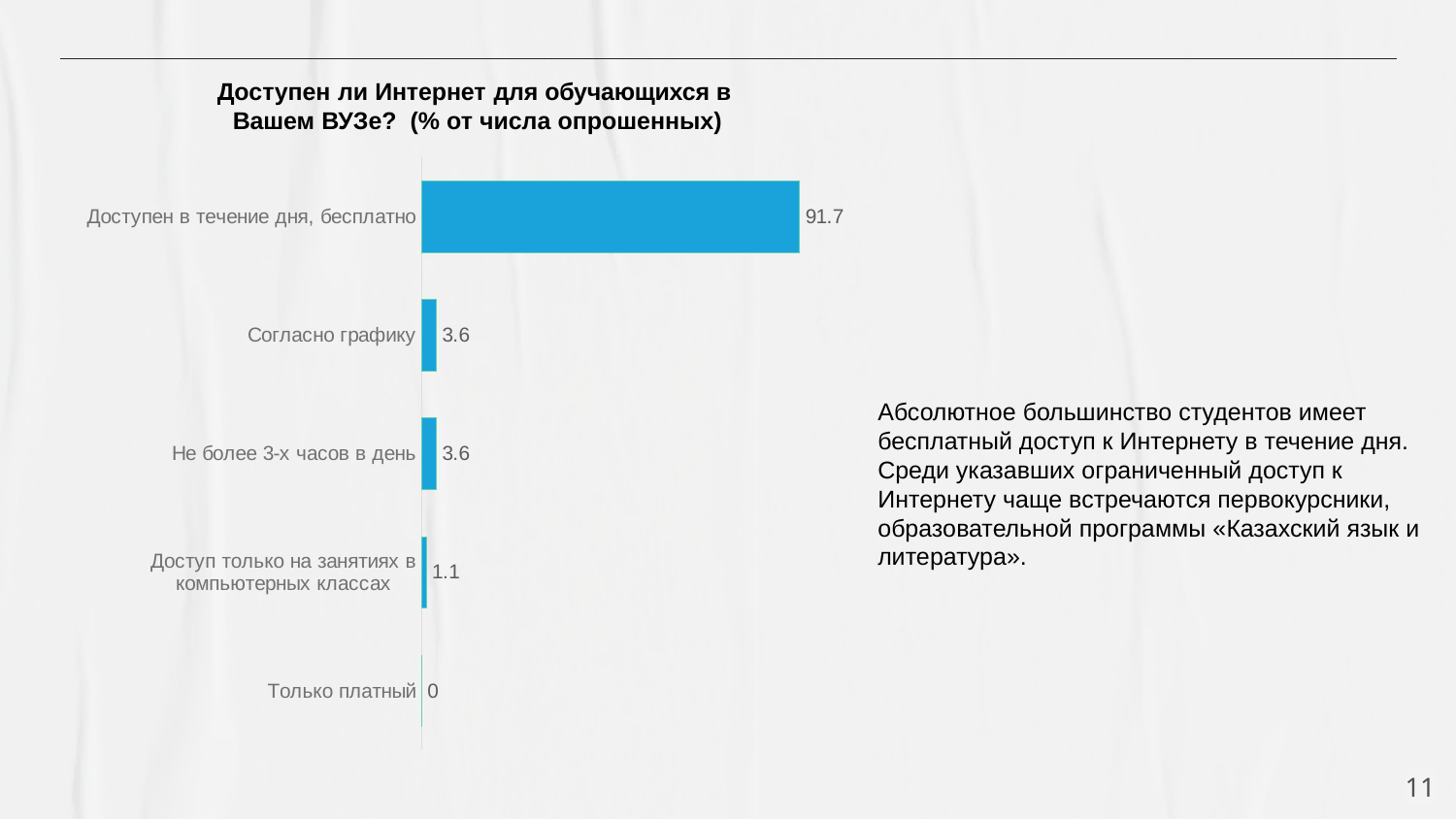
What is the value for "Доступ только на занятиях в компьютерных классах"? 1.1 How many categories are shown in the chart? 5 Which is larger: the value for "Согласно графику" or the value for "Доступ только на занятиях в компьютерных классах"? Согласно графику Which category has the highest value? Доступен в течение дня, бесплатно What is the value for "Согласно графику"? 3.6 What is the value for "Доступен в течение дня, бесплатно"? 91.7 Which category has the lowest value? Только платный What is the difference between the values for "Доступен в течение дня, бесплатно" and "Согласно графику"? 88.1 What kind of chart is shown on the slide? Bar chart What is the title of the chart? Доступен ли Интернет для обучающихся в Вашем ВУЗе? (% от числа опрошенных) What is the difference between the values for "Не более 3-х часов в день" and "Доступ только на занятиях в компьютерных классах"? 2.5 What is the value for "Только платный"? 0